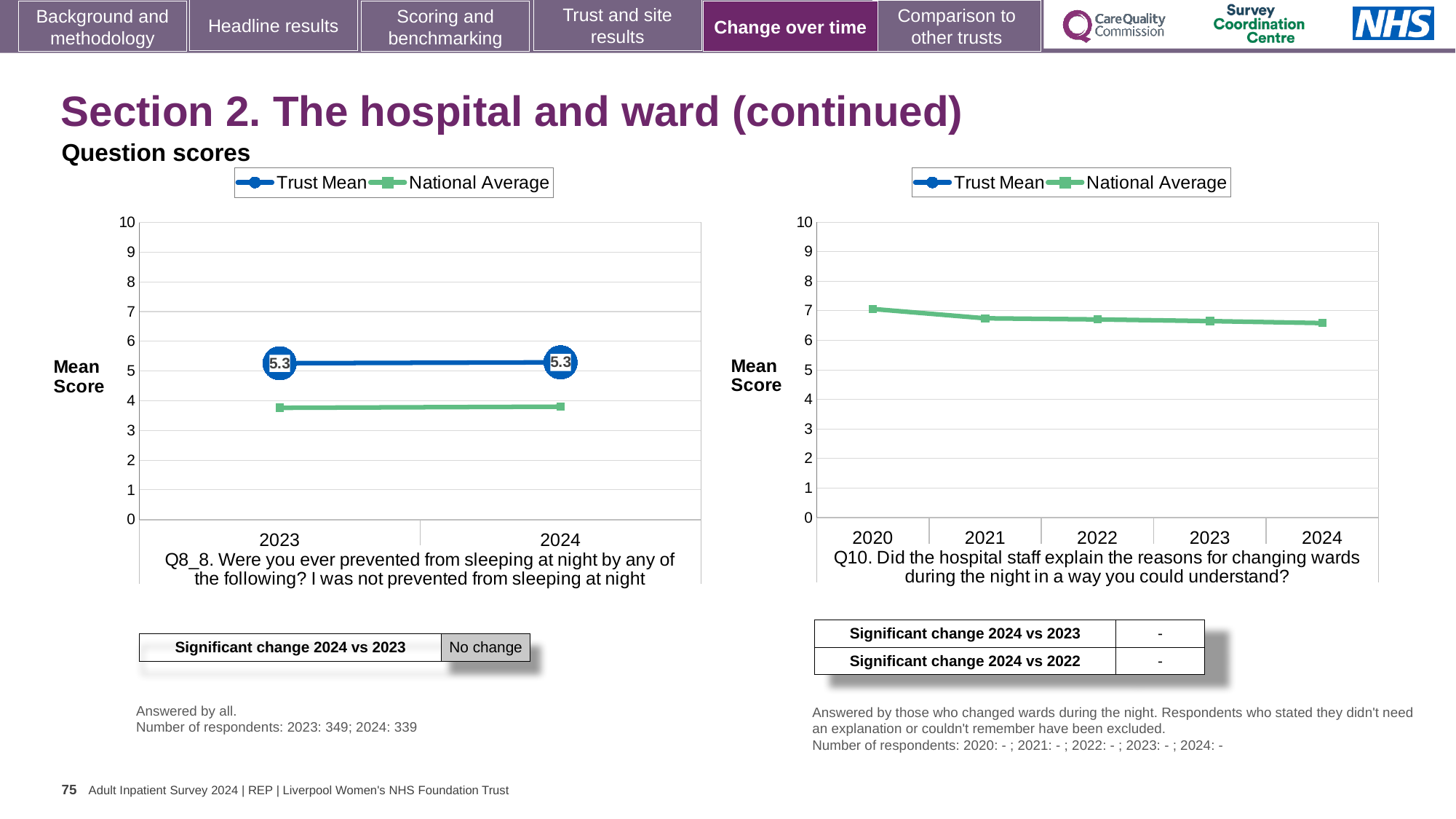
In the Q10 chart on the right, is the National Average value for 2020 greater or less than 6? greater In the Q8_8 chart on the left, what is the Trust Mean value for 2024? 5.3 In the Q8_8 chart on the left, is the National Average value for 2023 greater or less than 4? less In the Q8_8 chart on the left, what is the difference between the Trust Mean values for 2024 and 2023? 0 What type of chart is the Q10 chart on the right? Line chart In the Q8_8 chart on the left, how many series does the legend list? 2 In the Q8_8 chart on the left, which series is higher in 2024, Trust Mean or National Average? Trust Mean In the Q10 chart on the right, how many years are shown on the x axis? 5 In the Q8_8 chart on the left, what is the Trust Mean value for 2023? 5.3 In the Q8_8 chart on the left, how many years are shown on the x axis? 2 In the Q10 chart on the right, does the National Average line rise or fall from 2020 to 2024? Fall In the Q10 chart on the right, which year has the highest National Average value? 2020